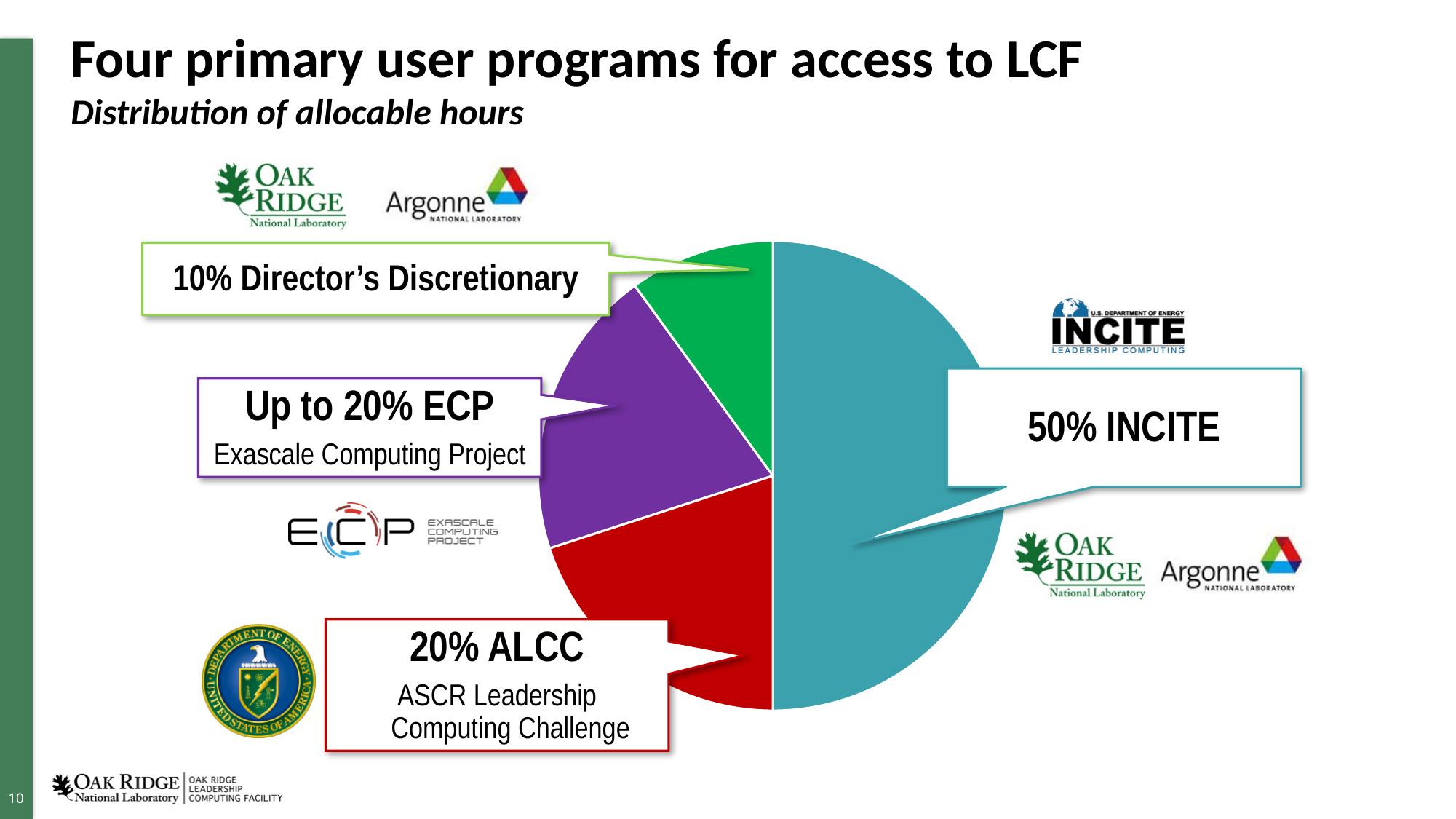
Which program has the largest share of allocable hours? INCITE What share of allocable hours goes to ALCC? 20% What share of allocable hours goes to INCITE? 50% What share of allocable hours is Director's Discretionary? 10% What is the difference between the INCITE share and the ALCC share? 30% What does ALCC stand for according to the slide? ASCR Leadership Computing Challenge How many slices does the pie chart have? 4 What colour is the INCITE slice of the pie chart? teal What kind of chart is shown on the slide? pie chart What share of allocable hours is allocated to ECP? Up to 20% Which has a larger share, INCITE or Director's Discretionary? INCITE Which program has the smallest share of allocable hours? Director's Discretionary